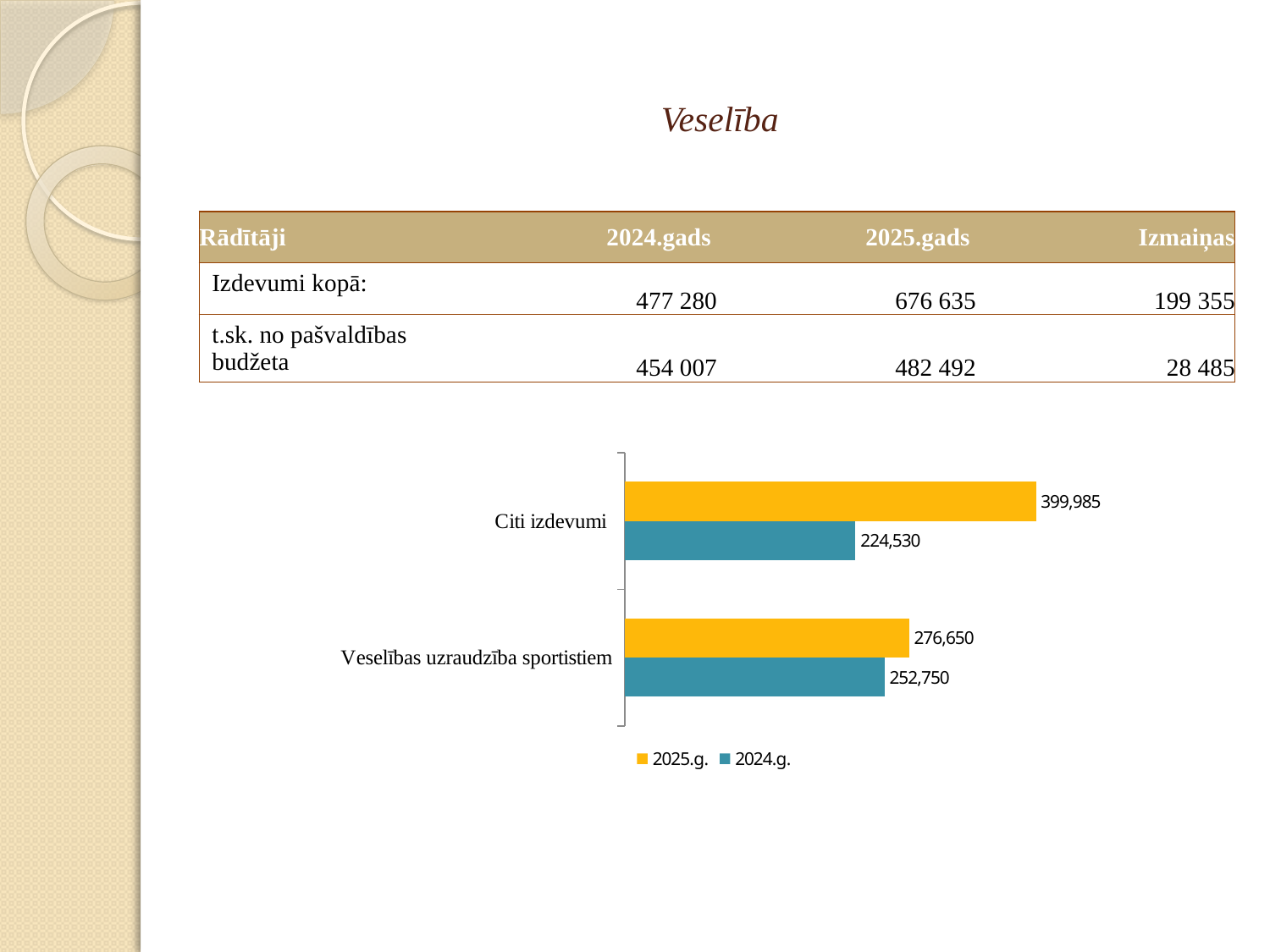
Which category has the lowest value in the 2024.g. series? Citi izdevumi What is the difference between the 2025.g. and 2024.g. values for Veselības uzraudzība sportistiem? 23,900 What kind of chart is shown on the slide? Bar chart What is the value for Veselības uzraudzība sportistiem in the 2025.g. series? 276,650 How many categories are shown in the chart? 2 What is the difference between the 2025.g. and 2024.g. values for Citi izdevumi? 175,455 What is the value for Citi izdevumi in the 2025.g. series? 399,985 Which category has the highest value in the 2025.g. series? Citi izdevumi What is the value for Citi izdevumi in the 2024.g. series? 224,530 How many series does the chart legend list? 2 What is the value for Veselības uzraudzība sportistiem in the 2024.g. series? 252,750 Which is larger: the 2024.g. value for Citi izdevumi or the 2024.g. value for Veselības uzraudzība sportistiem? Veselības uzraudzība sportistiem